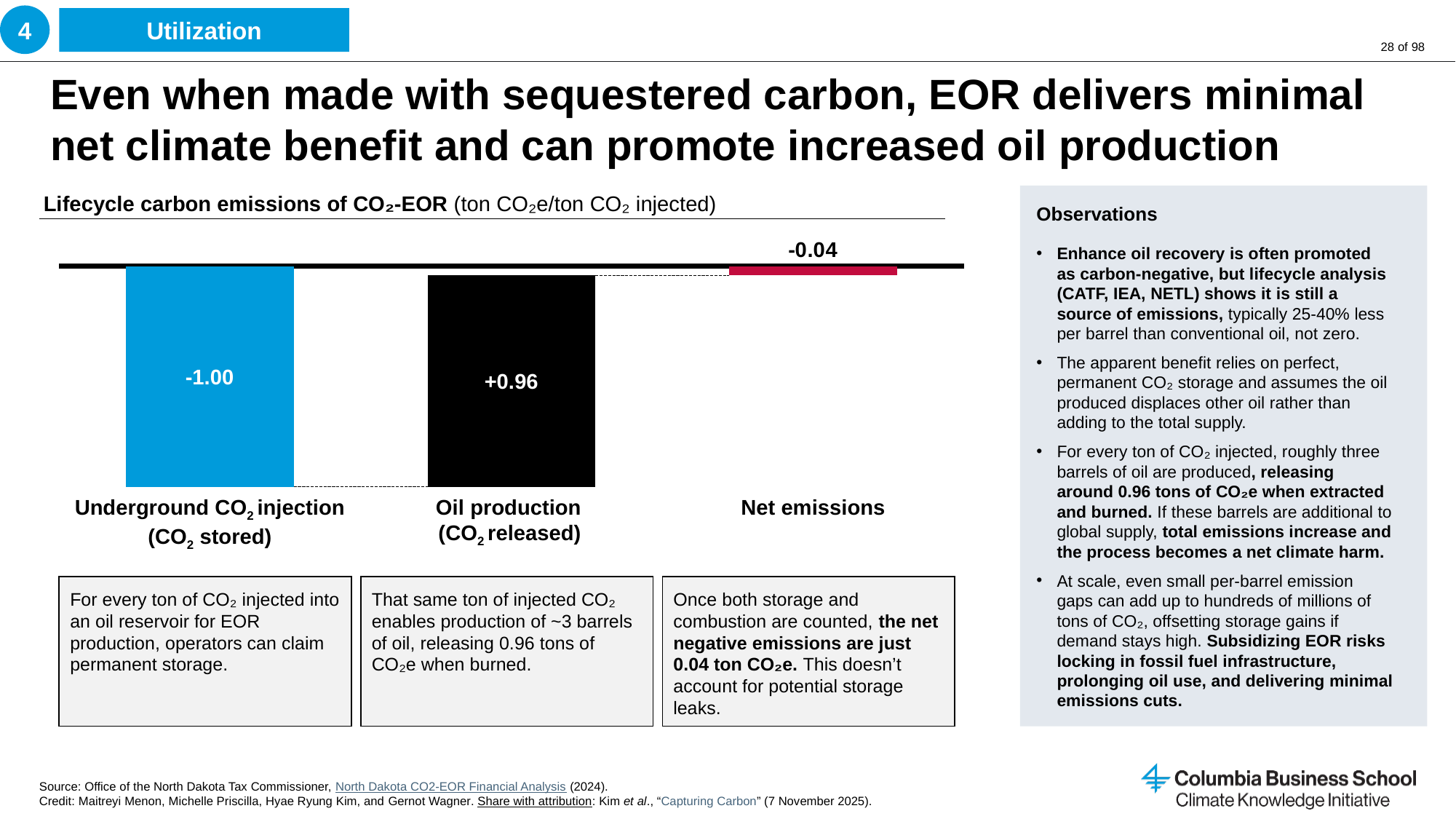
What is the value shown for Net emissions? -0.04 Which is larger, the value for Oil production or the value for Net emissions? Oil production What kind of chart is shown on the slide? Bar chart What is the difference between the Oil production value (+0.96) and the Underground CO2 injection value (-1.00)? 1.96 What unit is the chart measured in, according to the chart title? ton CO₂e/ton CO₂ injected How many categories are shown on the chart's x axis? 3 What is the value shown for Oil production (CO2 released)? +0.96 What is the title of the chart? Lifecycle carbon emissions of CO₂-EOR What is the value shown for Underground CO2 injection (CO2 stored)? -1.00 What is the sum of the Underground CO2 injection value and the Oil production value? -0.04 Which category has the highest value in the chart? Oil production (CO2 released) Which category has the lowest value in the chart? Underground CO2 injection (CO2 stored)